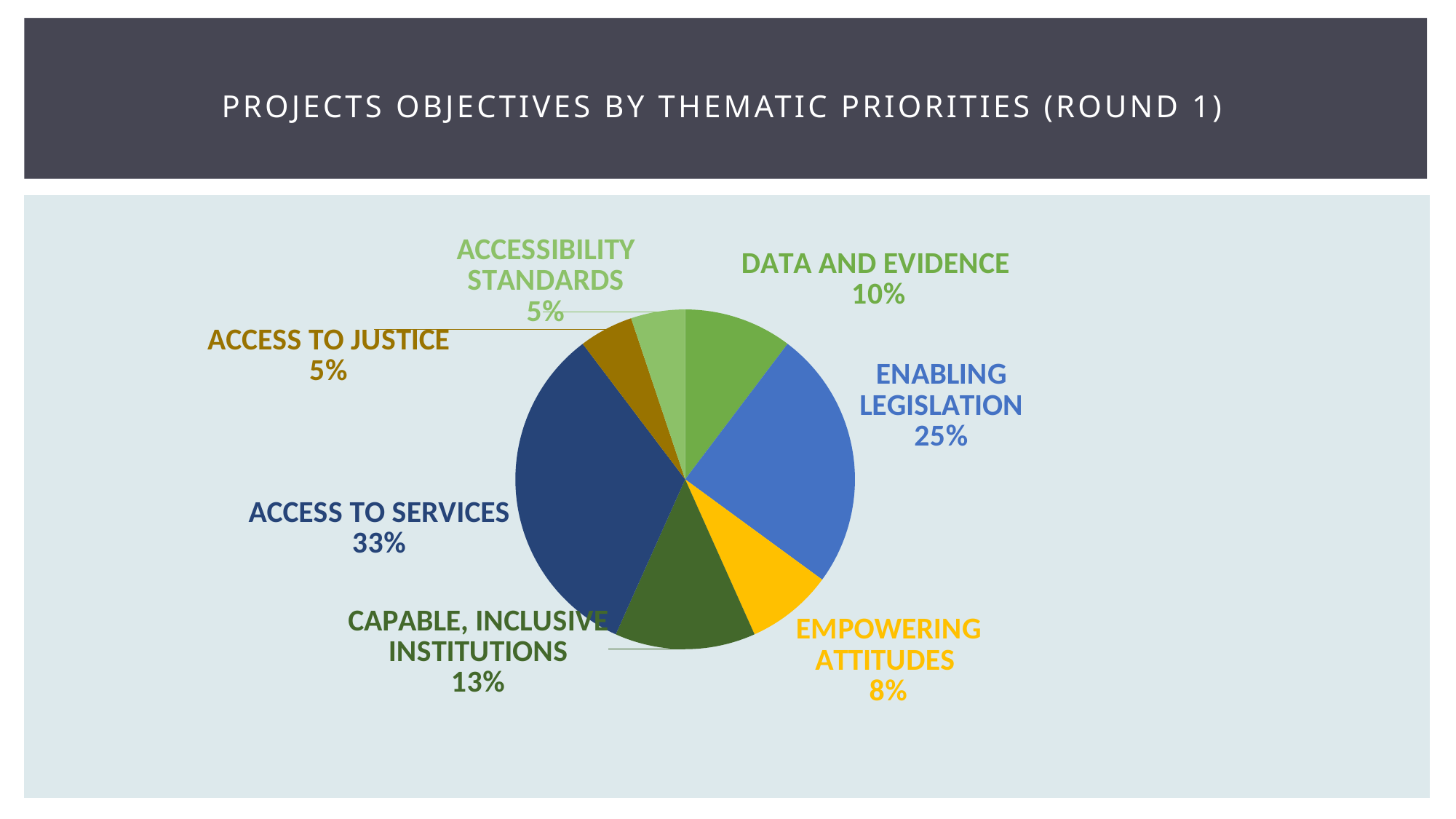
What is the title of the chart on the slide? Projects Objectives by Thematic Priorities (Round 1) What is the difference between the shares of Access to Services and Enabling Legislation? 8% What kind of chart is shown on the slide? pie chart How many categories are shown in the pie chart? 7 What share of the pie does Access to Services have? 33% What is the difference between Capable, Inclusive Institutions and Access to Justice? 8% What is the value for Capable, Inclusive Institutions? 13% What colour is the Empowering Attitudes slice? yellow Which category has the largest slice of the pie? Access to Services What is the value for Enabling Legislation? 25% What is the value for Empowering Attitudes? 8% Which is larger, Data and Evidence or Empowering Attitudes? Data and Evidence